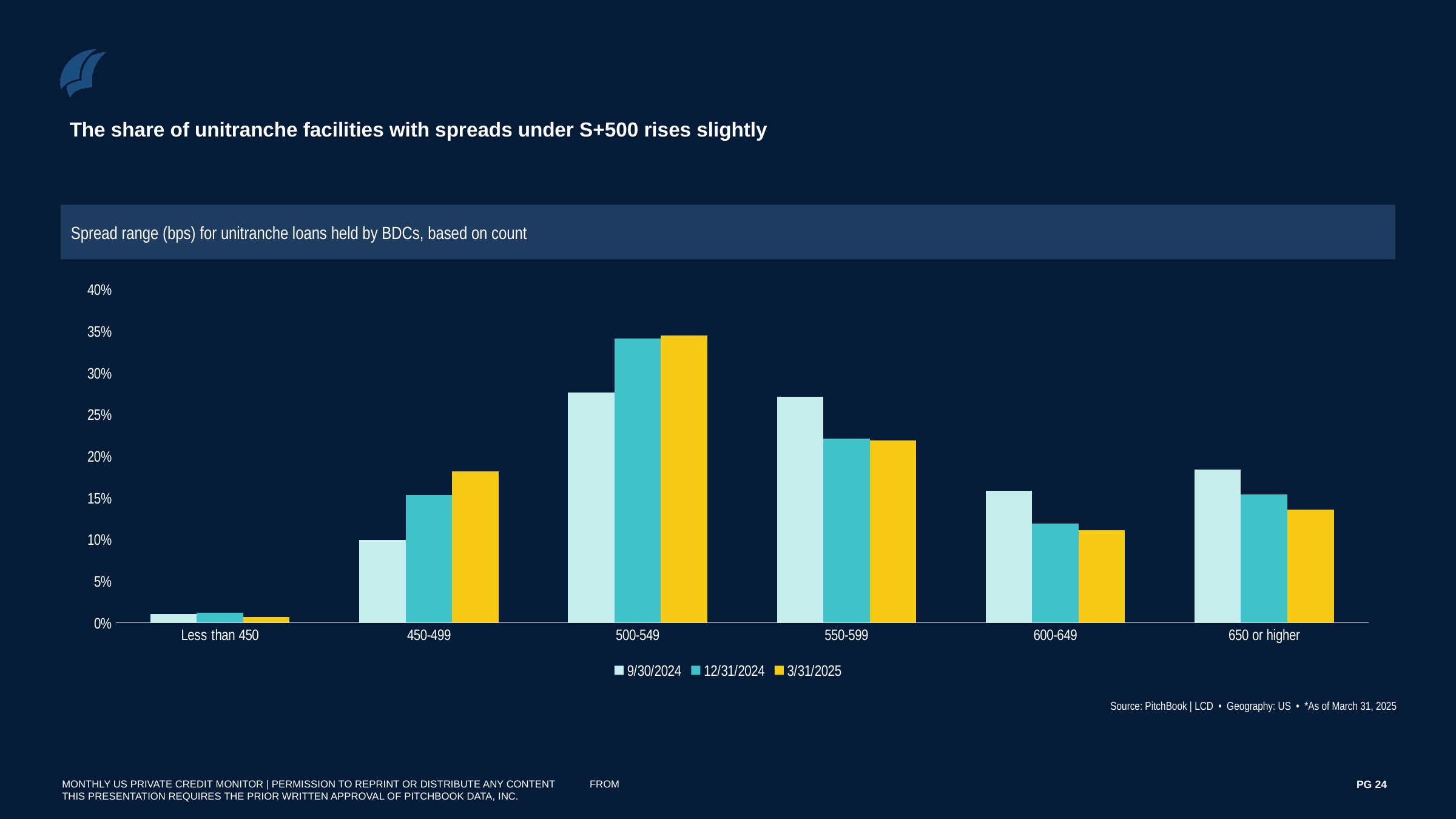
Is the value for 450-499 on 9/30/2024 greater or less than 15%? less What are the three dates listed in the legend? 9/30/2024, 12/31/2024, 3/31/2025 Which spread range has the highest share for 3/31/2025? 500-549 For the 450-499 range, which is larger: the 9/30/2024 value or the 3/31/2025 value? 3/31/2025 How many series does the legend list? 3 How many spread range categories are shown on the x axis? 6 Is the value for 500-549 on 12/31/2024 greater or less than 30%? greater Is the value for 600-649 on 3/31/2025 greater or less than 15%? less For the 650 or higher range, which is larger: the 9/30/2024 value or the 3/31/2025 value? 9/30/2024 For the 600-649 range, do the values rise or fall from 9/30/2024 to 3/31/2025? fall What kind of chart is shown on the slide? Bar chart Which spread range has the lowest share for 9/30/2024? Less than 450